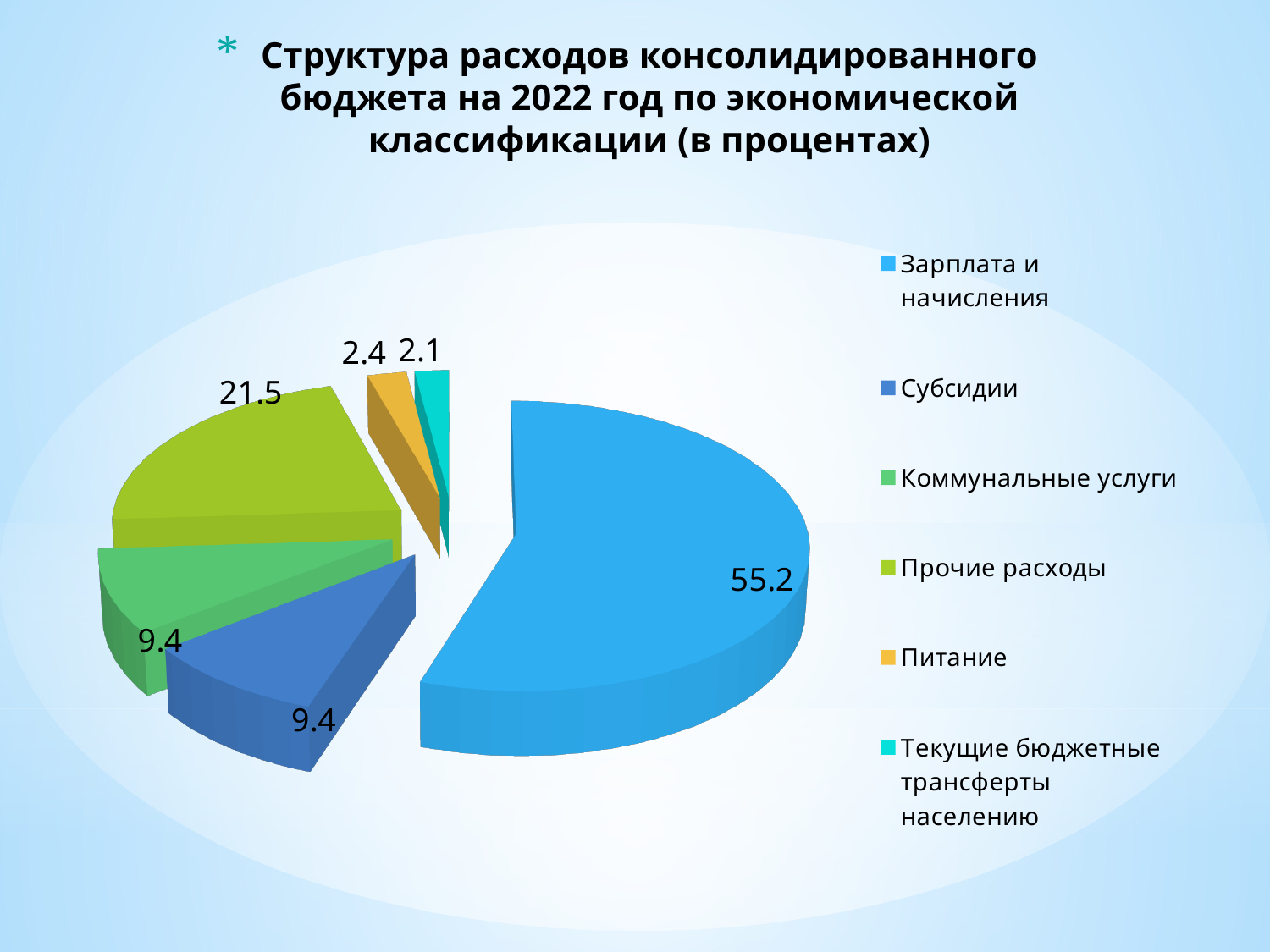
Which is larger, the value for Прочие расходы or the value for Коммунальные услуги? Прочие расходы What type of chart is shown on the slide? Pie chart Which category has the smallest slice of the pie? Текущие бюджетные трансферты населению How many slices does the pie chart have? 6 What is the value shown for Питание? 2.4 What is the value shown for Субсидии? 9.4 What is the value shown for Зарплата и начисления? 55.2 What is the difference between the values for Зарплата и начисления and Прочие расходы? 33.7 Which category has the largest slice of the pie? Зарплата и начисления What is the value shown for Текущие бюджетные трансферты населению? 2.1 How many entries does the legend list? 6 What is the value shown for Прочие расходы? 21.5